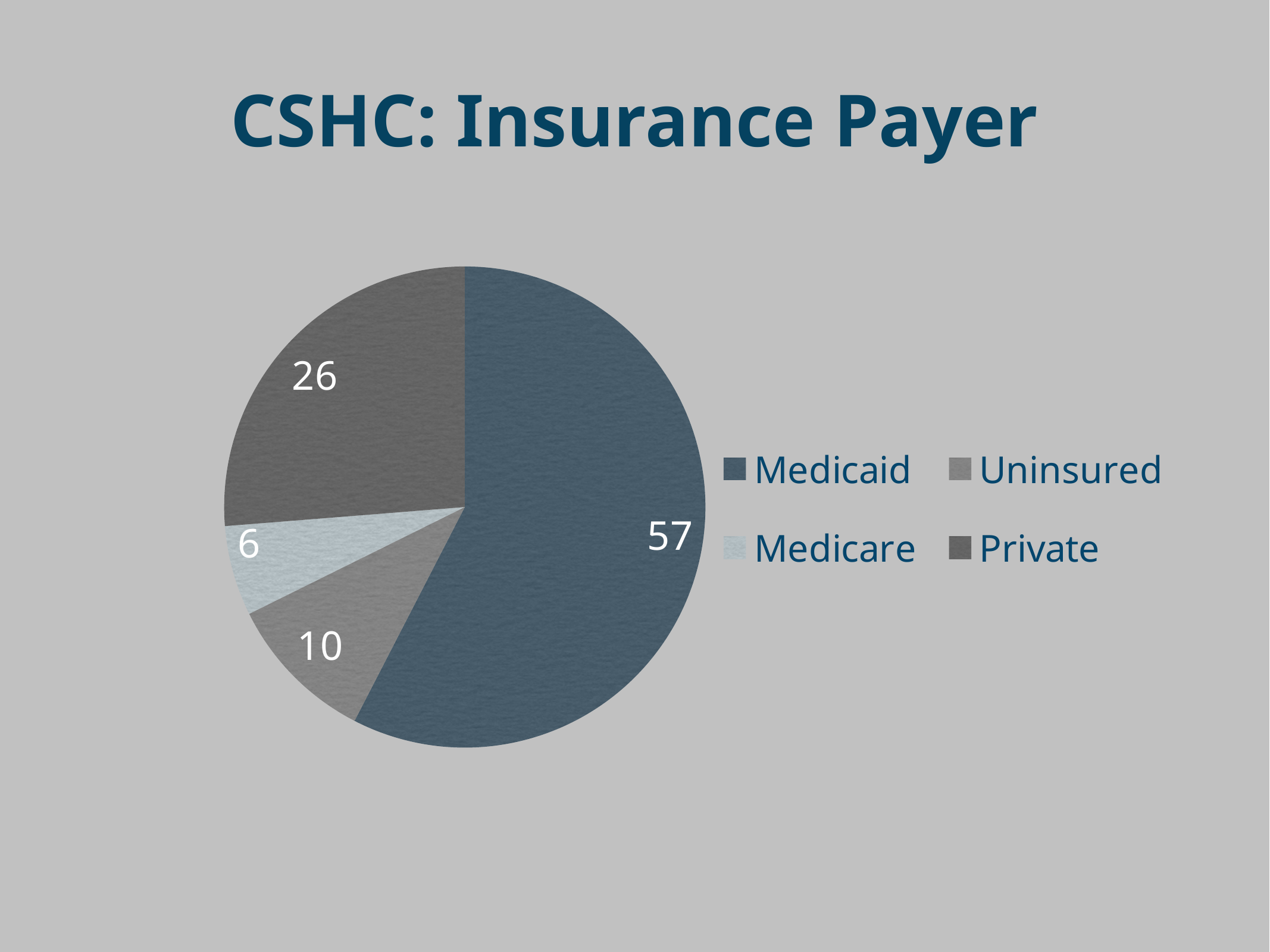
What is the difference between the Medicaid and Private values? 31 Which insurance payer has the smallest slice? Medicare Which insurance payer has the largest slice? Medicaid What is the difference between the Uninsured and Medicare values? 4 What is the title of the chart? CSHC: Insurance Payer What is the value for Uninsured? 10 What type of chart is shown on the slide? pie chart What is the value for Medicare? 6 Which is larger, Private or Uninsured? Private What is the value for Medicaid? 57 What is the value for Private? 26 How many slices does the pie chart have? 4